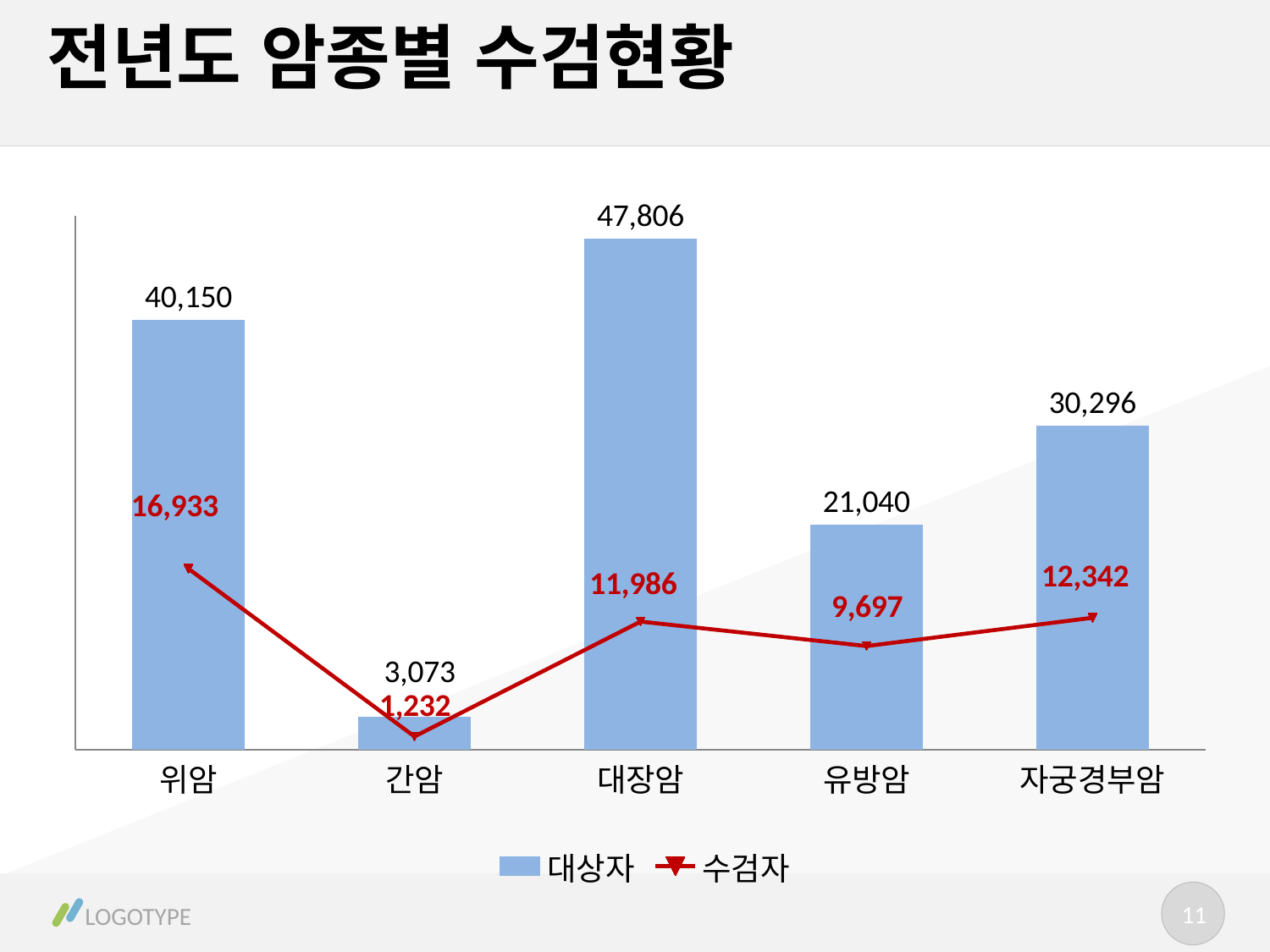
Which category has the highest 대상자 value? 대장암 Which category has the lowest 수검자 value? 간암 What is the 수검자 value for 위암? 16,933 What is the difference between the 대상자 and 수검자 values for 간암? 1,841 What is the difference between the 대상자 values for 대장암 and 위암? 7,656 How many categories are shown on the x axis? 5 What is the 대상자 value for 대장암? 47,806 What is the title of the slide containing the chart? 전년도 암종별 수검현황 What is the 대상자 value for 자궁경부암? 30,296 How many series does the legend list? 2 Which is larger, the 수검자 value for 대장암 or for 자궁경부암? 자궁경부암 What is the 수검자 value for 유방암? 9,697